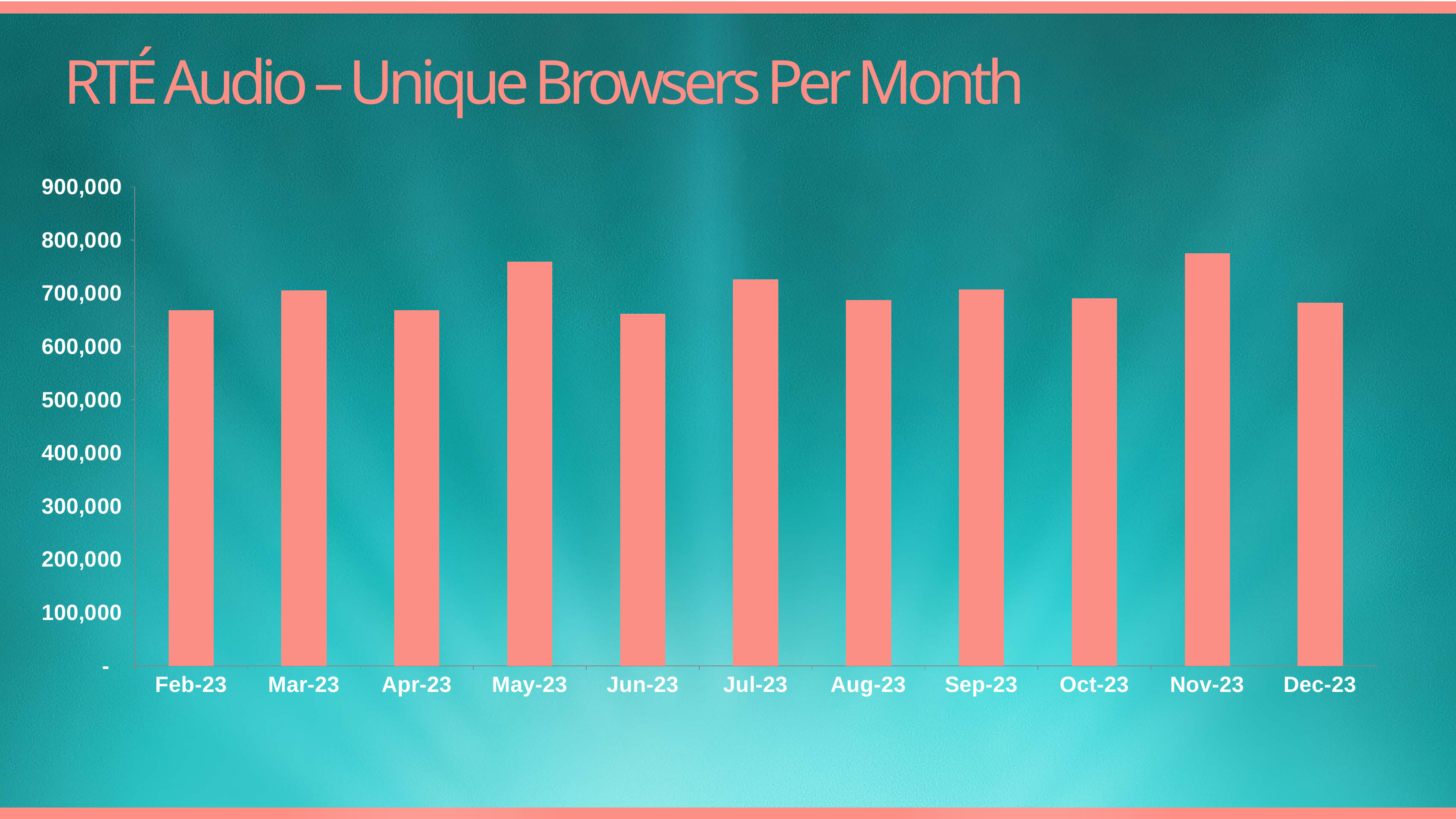
Which is larger, the value for Jul-23 or the value for Aug-23? Jul-23 What kind of chart is shown on the slide? bar chart Is the value for Jun-23 greater or less than 700,000? less Is the value for Feb-23 greater or less than 700,000? less What is the title of the chart? RTÉ Audio – Unique Browsers Per Month Is the value for May-23 greater or less than 700,000? greater Which is larger, the value for May-23 or the value for Jun-23? May-23 Does the value rise or fall from Nov-23 to Dec-23? fall How many months are shown on the x axis of the chart? 11 Which month has the highest number of unique browsers? Nov-23